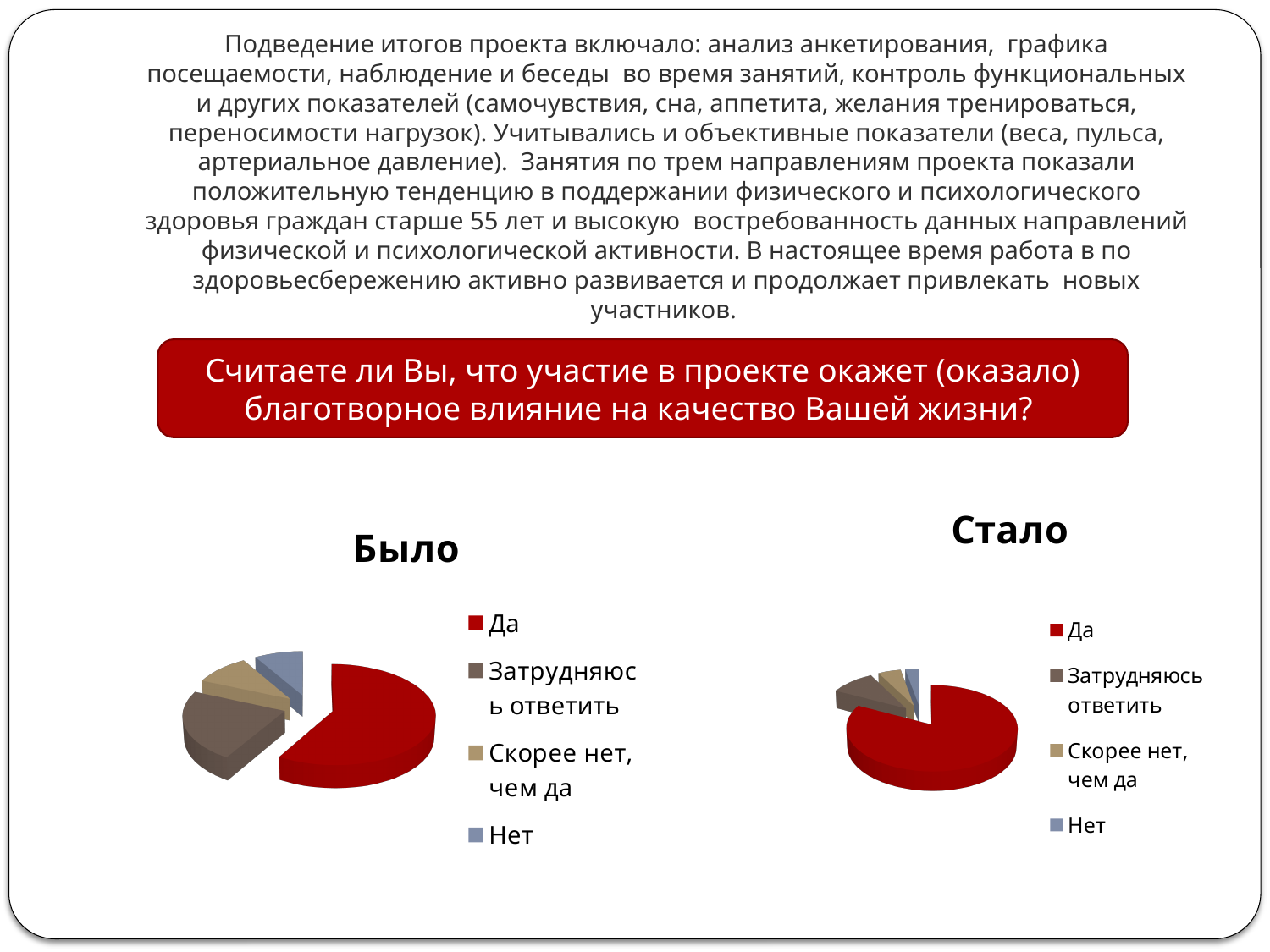
In the "Было" chart, how many slices does the pie have? 4 In the "Было" chart, which answer has the largest slice? Да What kind of chart is the "Стало" chart? pie chart What is the title of the pie chart on the right side of the slide? Стало In the "Стало" chart, which answer has the smallest slice? Нет In the "Было" chart, which slice is larger: "Да" or "Затрудняюсь ответить"? Да How many entries does the legend of the "Стало" chart list? 4 In the "Стало" chart, which answer has the largest slice? Да What kind of chart is the "Было" chart? pie chart In the "Стало" chart, what colour is the "Да" slice? red In the "Было" chart, which slice is larger: "Затрудняюсь ответить" or "Нет"? Затрудняюсь ответить